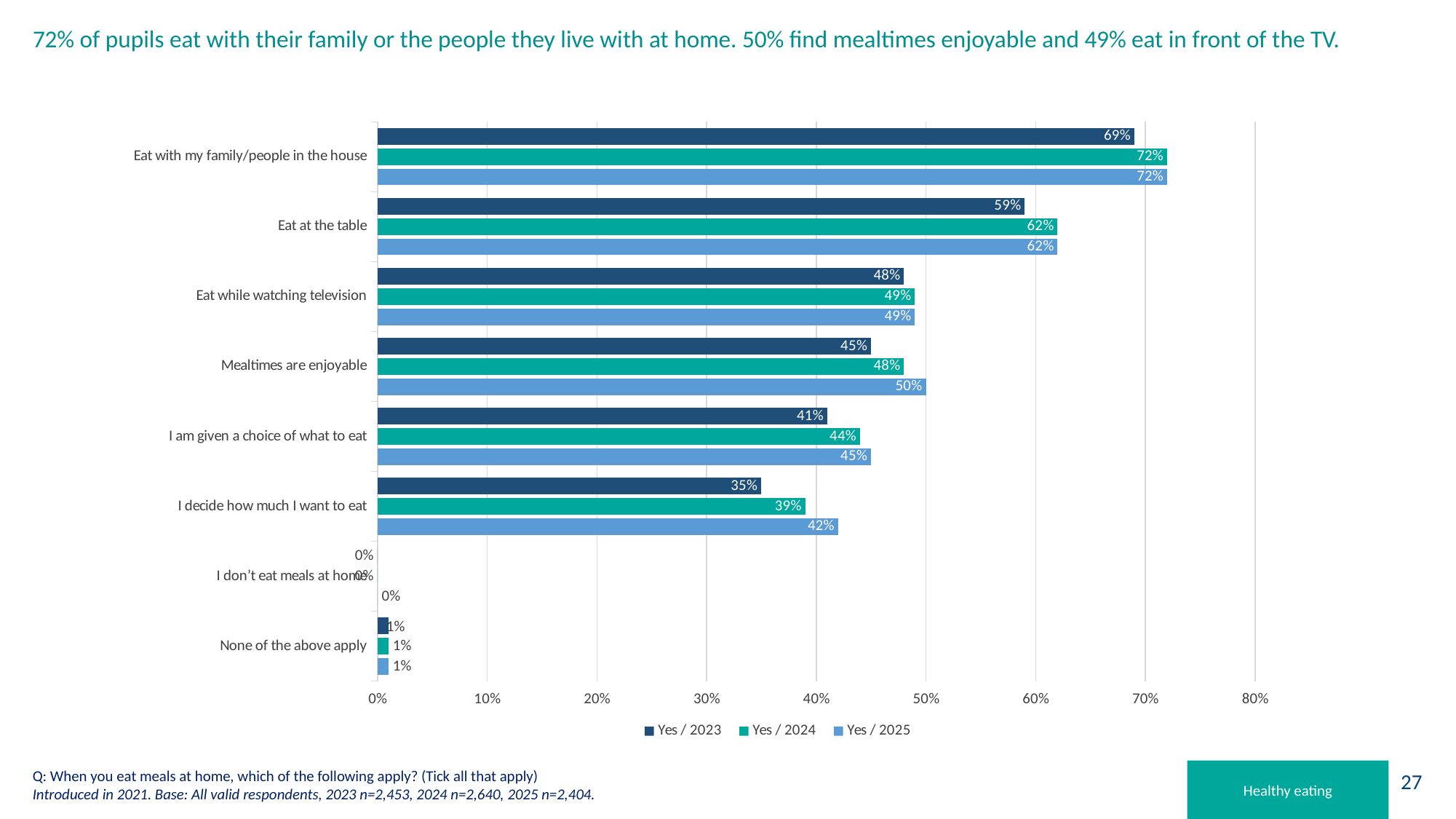
What is the value for "Eat with my family/people in the house" in the Yes / 2025 series? 72% What is the label of the third series in the legend? Yes / 2025 What kind of chart is shown on the slide? Bar chart What is the value for "Eat at the table" in the Yes / 2023 series? 59% Which category has the lowest value in the Yes / 2025 series? I don't eat meals at home Which is larger for "I am given a choice of what to eat": the Yes / 2024 value or the Yes / 2025 value? Yes / 2025 What is the value for "Mealtimes are enjoyable" in the Yes / 2024 series? 48% How many categories are shown on the chart? 8 What is the value for "I decide how much I want to eat" in the Yes / 2025 series? 42% How many series does the legend list? 3 Which category has the highest value in the Yes / 2023 series? Eat with my family/people in the house What is the difference between the Yes / 2025 and Yes / 2023 values for "I decide how much I want to eat"? 7%